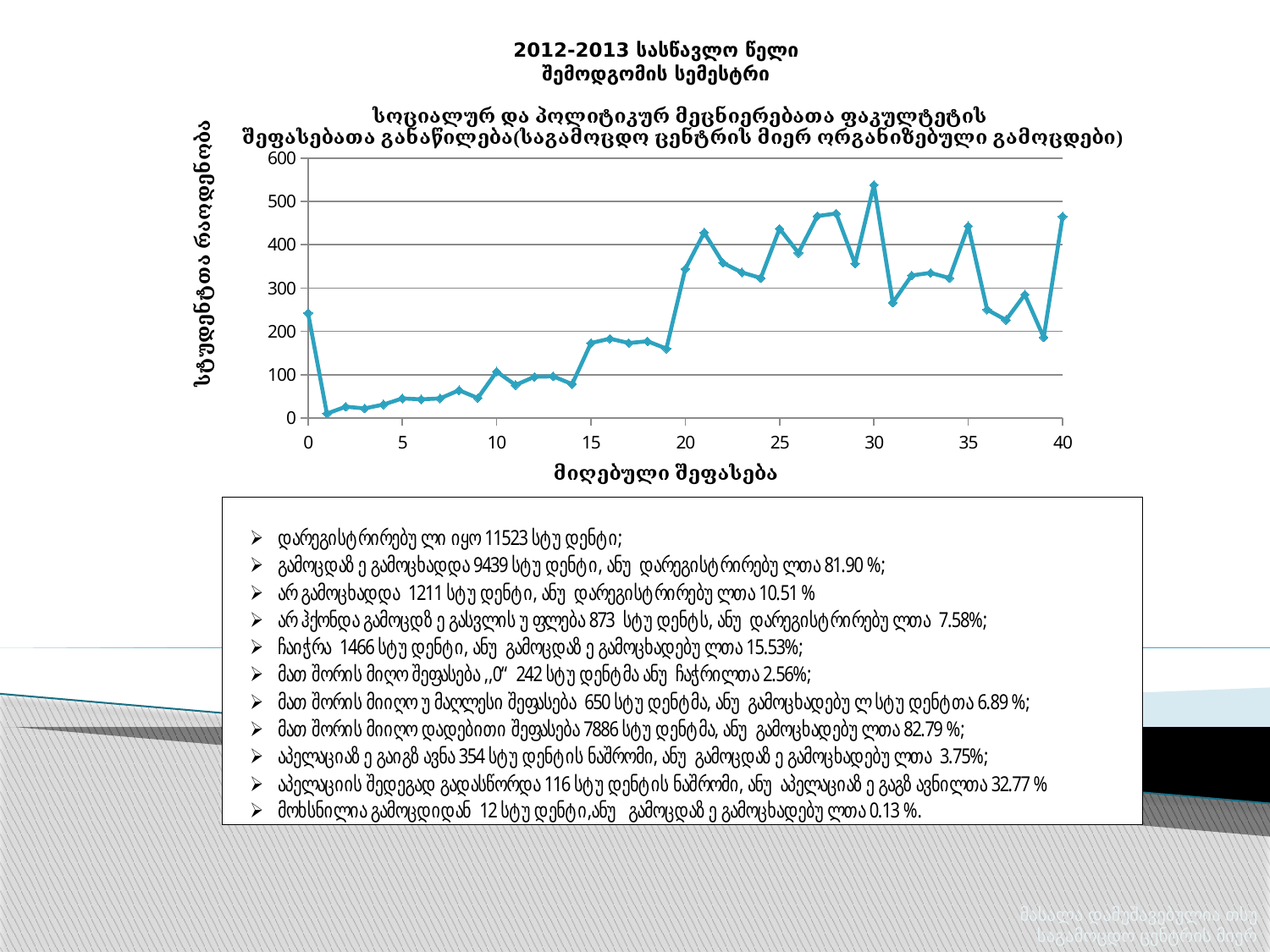
At which score on the x axis does the line reach its highest number of students? 30 Is the number of students at score 10 greater or less than 200? less What kind of chart is shown on the slide? line chart Which score has more students, 20 or 30? 30 Is the number of students at score 30 greater or less than 500? greater At which score on the x axis does the line reach its lowest number of students? 1 Does the line generally rise or fall between score 1 and score 30? rise Is the number of students at score 39 greater or less than 300? less Which score has more students, 5 or 25? 25 What is the title of the x axis of the chart? მიღებული შეფასება